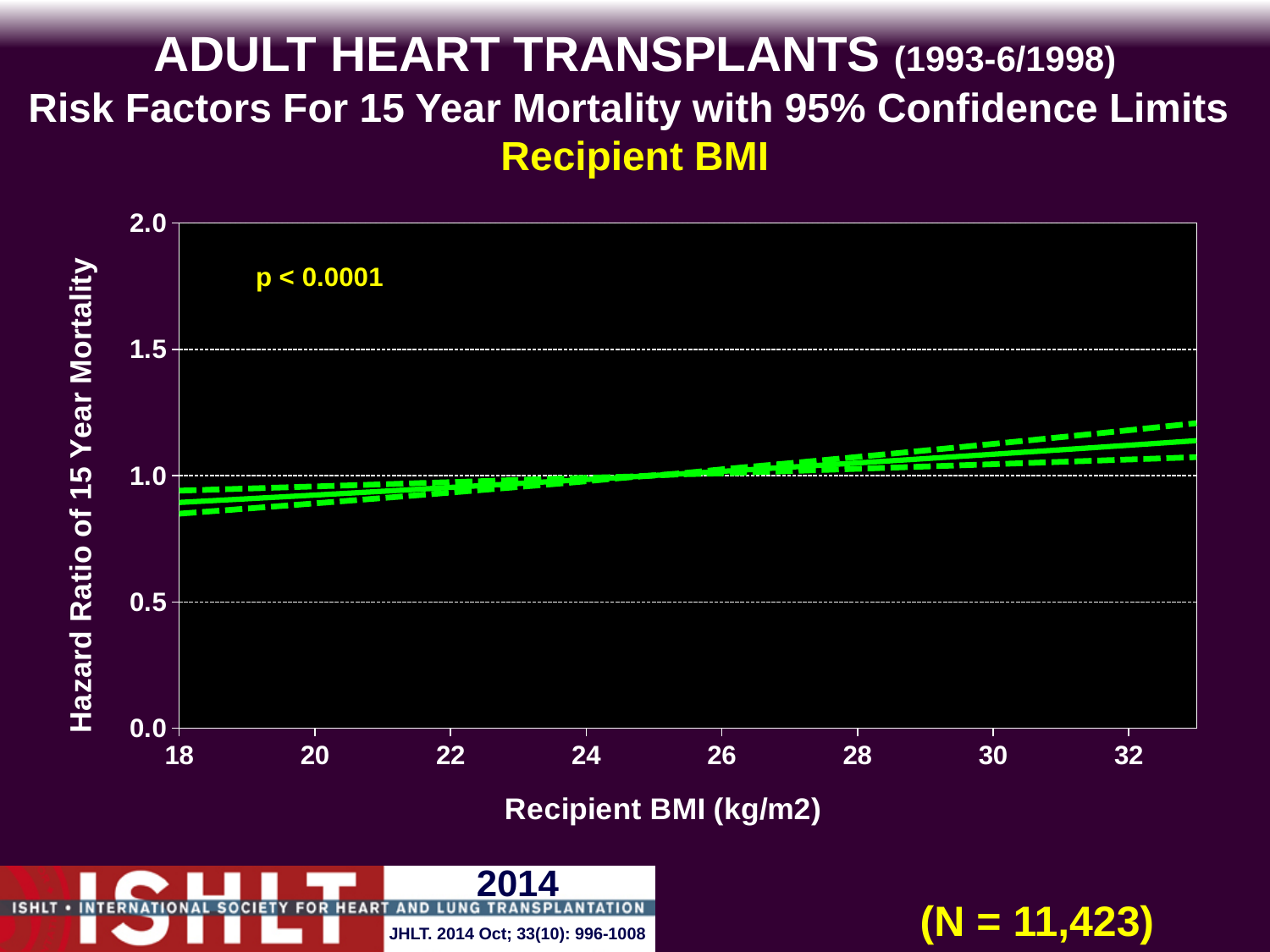
Which recipient BMI shown on the x axis has the higher hazard ratio, 18 or 32? 32 Does the hazard ratio of 15 year mortality rise or fall as recipient BMI increases from 18 to 32? rise Is the hazard ratio at a recipient BMI of 32 greater or less than 1.5? less Is the hazard ratio at a recipient BMI of 18 greater or less than 0.5? greater Is the hazard ratio at a recipient BMI of 18 greater or less than 1.0? less What is the highest value shown on the y axis? 2.0 At which end of the x axis, BMI 18 or BMI 32, is the hazard ratio lowest? 18 How many lines (estimate plus confidence limits) are plotted on the chart? 3 What kind of chart is shown on the slide? line chart What p-value is printed on the chart? p < 0.0001